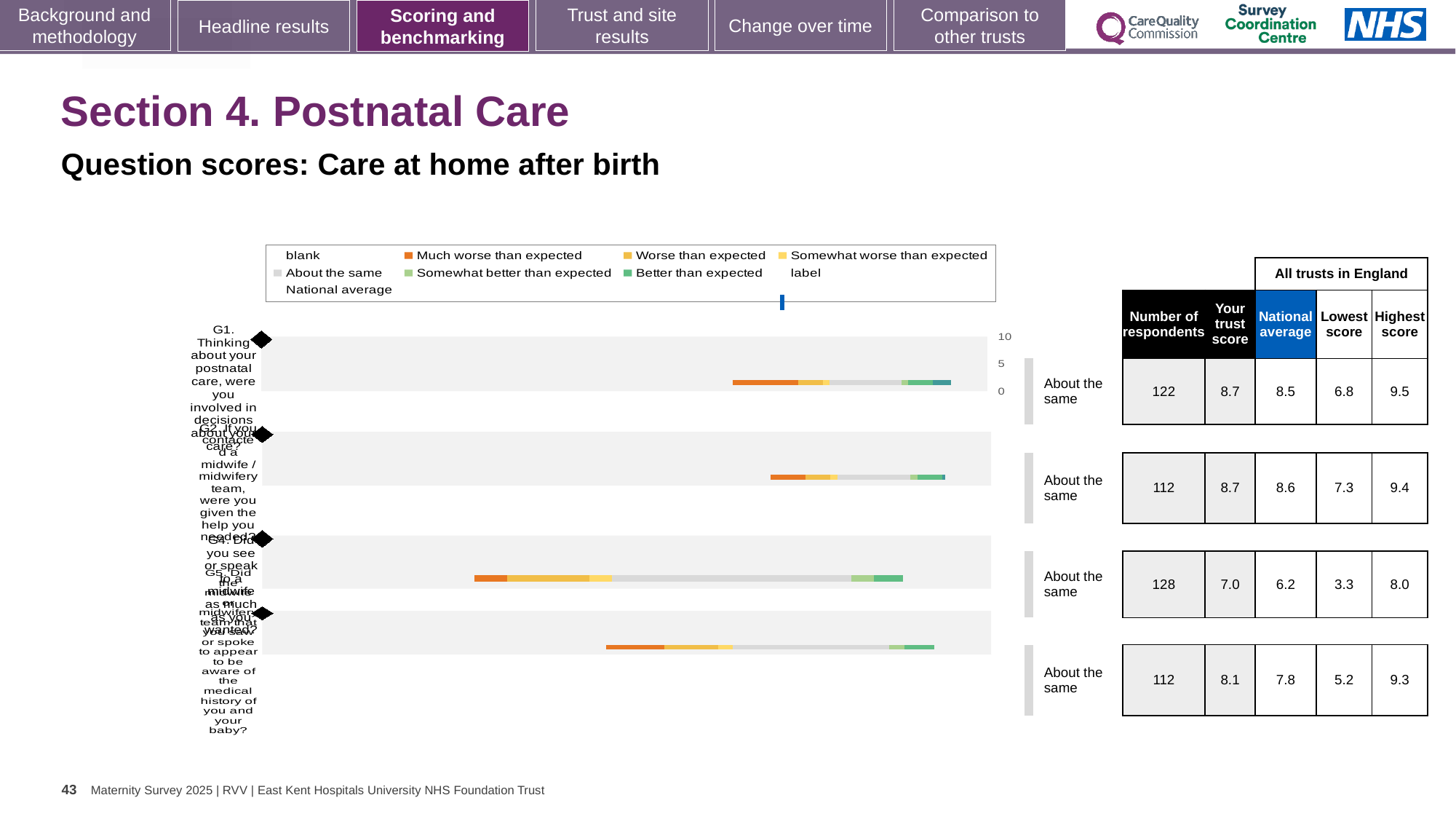
What is the lowest score in England shown for the third row of the table? 3.3 What benchmark label is shown next to the bar for question G1? About the same In the table beside the chart, what is the trust score for question G2? 8.7 For the third row, which is larger: the trust score or the national average? the trust score (7.0) What kind of chart is shown on the slide? bar chart How many question bars are plotted in the chart? 4 For question G1, what is the difference between the trust score and the national average? 0.2 In the table beside the chart, what is the number of respondents for question G1? 122 In the table beside the chart, what is the national average for the third row? 6.2 Which row of the table has the lowest 'Your trust score'? the third row (7.0) What colour does the legend use for 'Much worse than expected'? orange What is the highest score in England shown for the fourth row of the table? 9.3